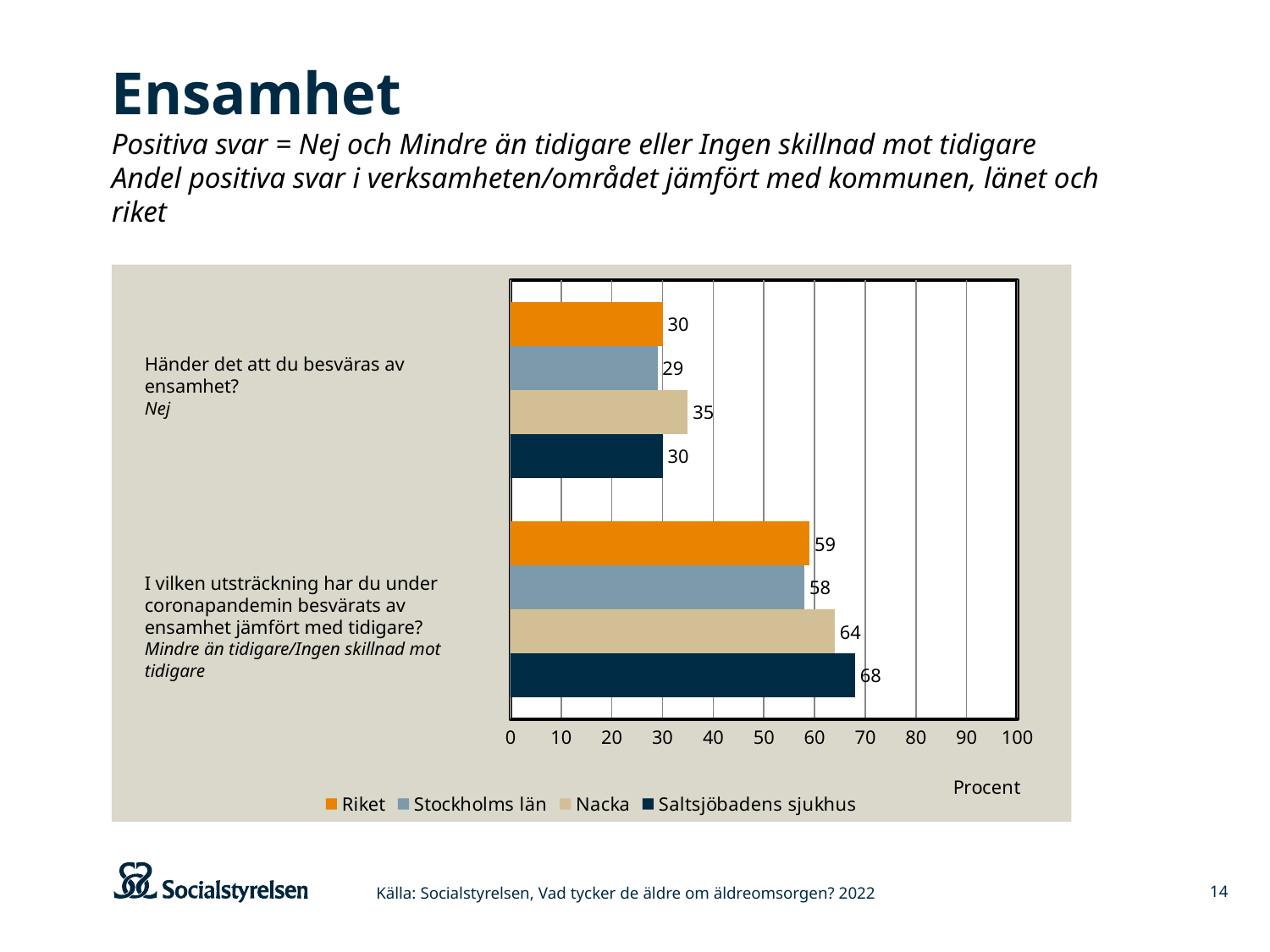
What is the difference between Nacka and Stockholms län for the question "Händer det att du besväras av ensamhet?"? 6 How many series does the legend list? 4 What kind of chart is shown on the slide? Bar chart What is the value for Stockholms län for the question "Händer det att du besväras av ensamhet?"? 29 Which series has the highest value for the question "I vilken utsträckning har du under coronapandemin besvärats av ensamhet jämfört med tidigare?"? Saltsjöbadens sjukhus For the question "I vilken utsträckning har du under coronapandemin besvärats av ensamhet jämfört med tidigare?", which is larger: Nacka or Stockholms län? Nacka Which series has the highest value for the question "Händer det att du besväras av ensamhet?"? Nacka What is the value for Nacka for the question "Händer det att du besväras av ensamhet?"? 35 What is the value for Riket for the question "I vilken utsträckning har du under coronapandemin besvärats av ensamhet jämfört med tidigare?"? 59 What unit is shown on the horizontal axis of the chart? Procent What is the value for Saltsjöbadens sjukhus for the question "I vilken utsträckning har du under coronapandemin besvärats av ensamhet jämfört med tidigare?"? 68 What is the difference between Saltsjöbadens sjukhus and Riket for the question "I vilken utsträckning har du under coronapandemin besvärats av ensamhet jämfört med tidigare?"? 9